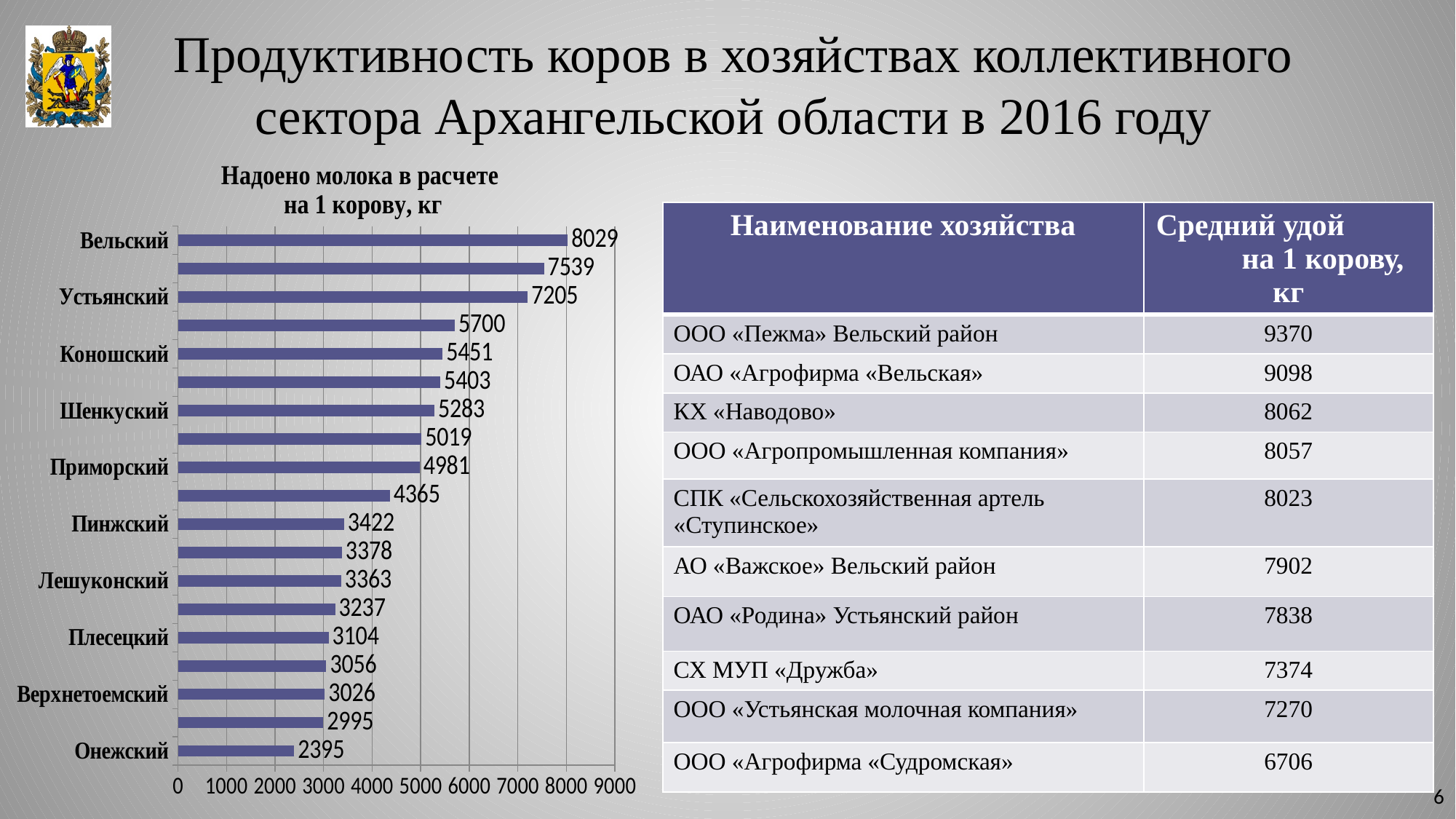
What kind of chart is shown on the slide? bar chart Which is larger, the value for Шенкуский or the value for Приморский? Шенкуский What is the value for Устьянский? 7205 What is the title of the chart? Надоено молока в расчете на 1 корову, кг What is the value for Коношский? 5451 What is the difference between the values for Вельский and Онежский? 5634 How many bars are plotted in the chart? 19 Which category has the highest value? Вельский Which category has the lowest value? Онежский Is the value for Плесецкий greater or less than 4000? less What is the value for Онежский? 2395 What is the value for Вельский? 8029